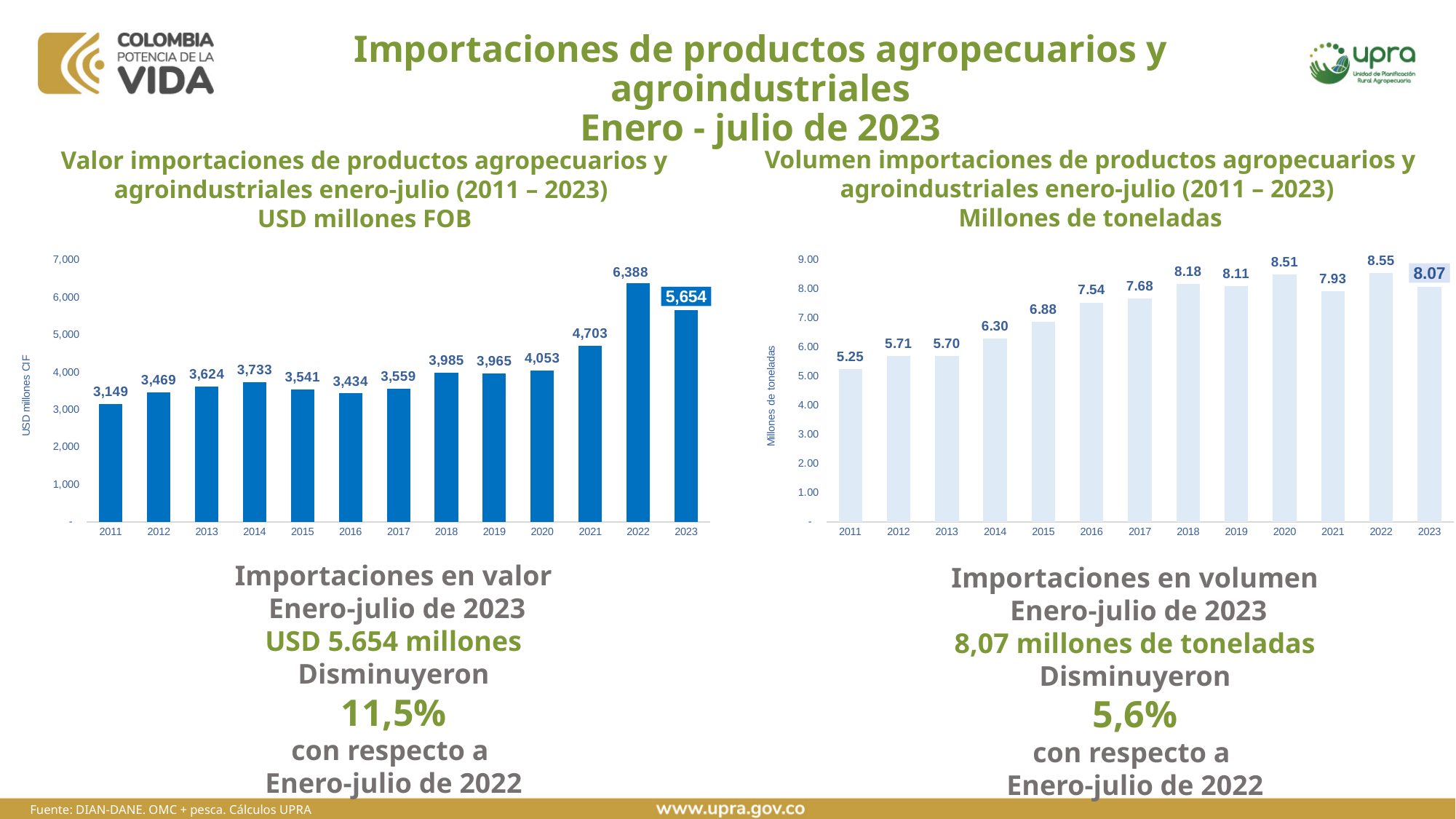
In the right chart (Volumen importaciones), what is the difference between the values for 2022 and 2023? 0.48 In the right chart (Volumen importaciones), which year has the highest value? 2022 In the left chart (Valor importaciones), what is the value for 2022? 6,388 In the right chart (Volumen importaciones), which year has the lowest value? 2011 What type of chart is the right chart (Volumen importaciones)? bar chart In the left chart (Valor importaciones), what is the value for 2011? 3,149 In the left chart (Valor importaciones), which year has the lowest value? 2011 In the left chart (Valor importaciones), what is the difference between the values for 2022 and 2023? 734 In the right chart (Volumen importaciones), what is the value for 2020? 8.51 In the left chart (Valor importaciones), how many years are plotted? 13 In the left chart (Valor importaciones), which year has the highest value? 2022 In the right chart (Volumen importaciones), is the value for 2021 larger or smaller than the value for 2019? smaller